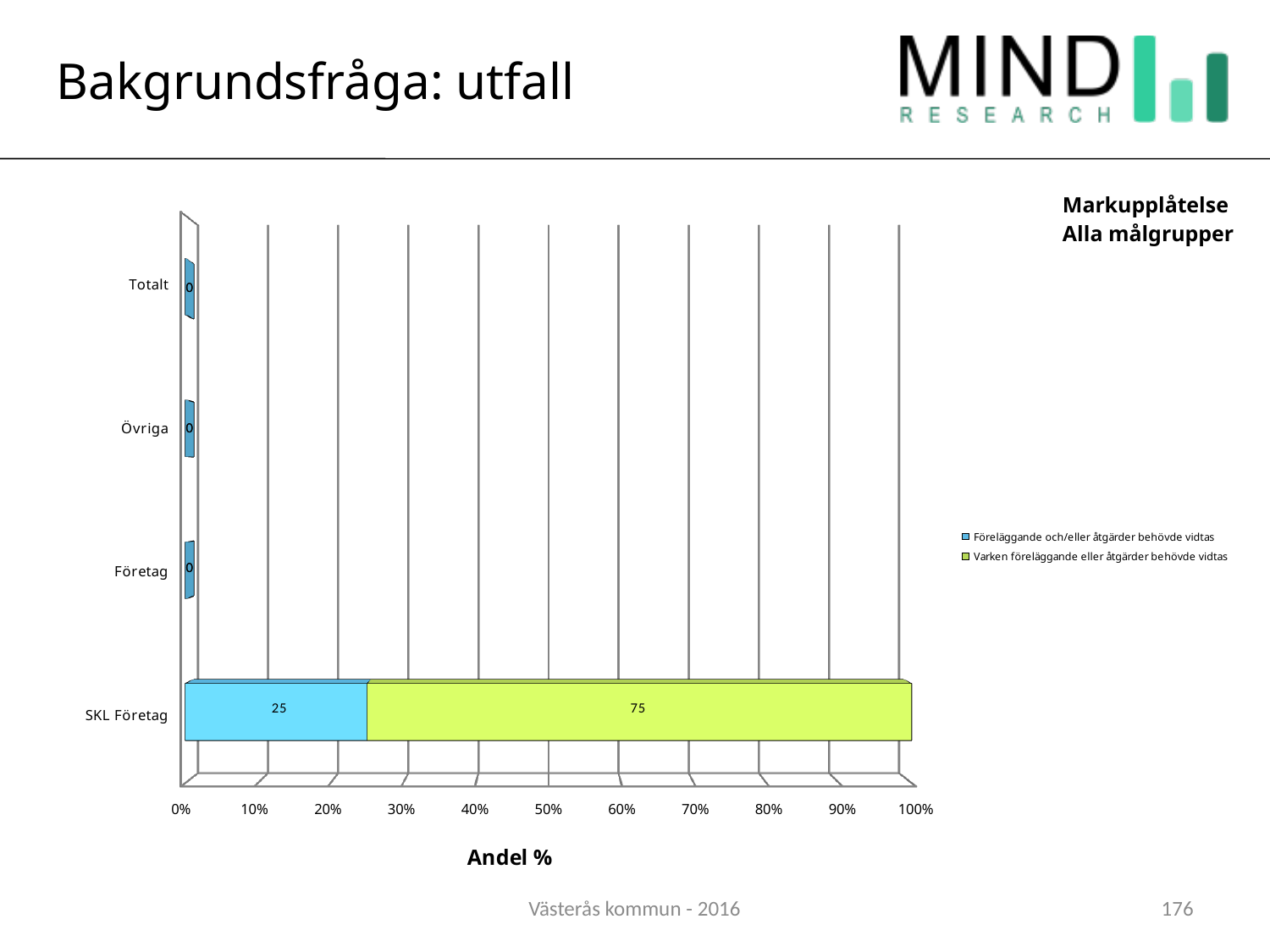
Which category has the longest bar in the chart? SKL Företag What is the label of the horizontal axis? Andel % What is the value labelled on the bar for Företag? 0 What is the value for 'Varken föreläggande eller åtgärder behövde vidtas' for SKL Företag? 75 What is the total of the stacked bar for SKL Företag? 100 What is the difference between the two segments of the SKL Företag bar? 50 How many series does the chart legend list? 2 How many categories are shown on the vertical axis of the chart? 4 What is the value labelled on the bar for Övriga? 0 What is the value labelled on the bar for Totalt? 0 What kind of chart is shown on the slide? bar chart What is the value for 'Föreläggande och/eller åtgärder behövde vidtas' for SKL Företag? 25